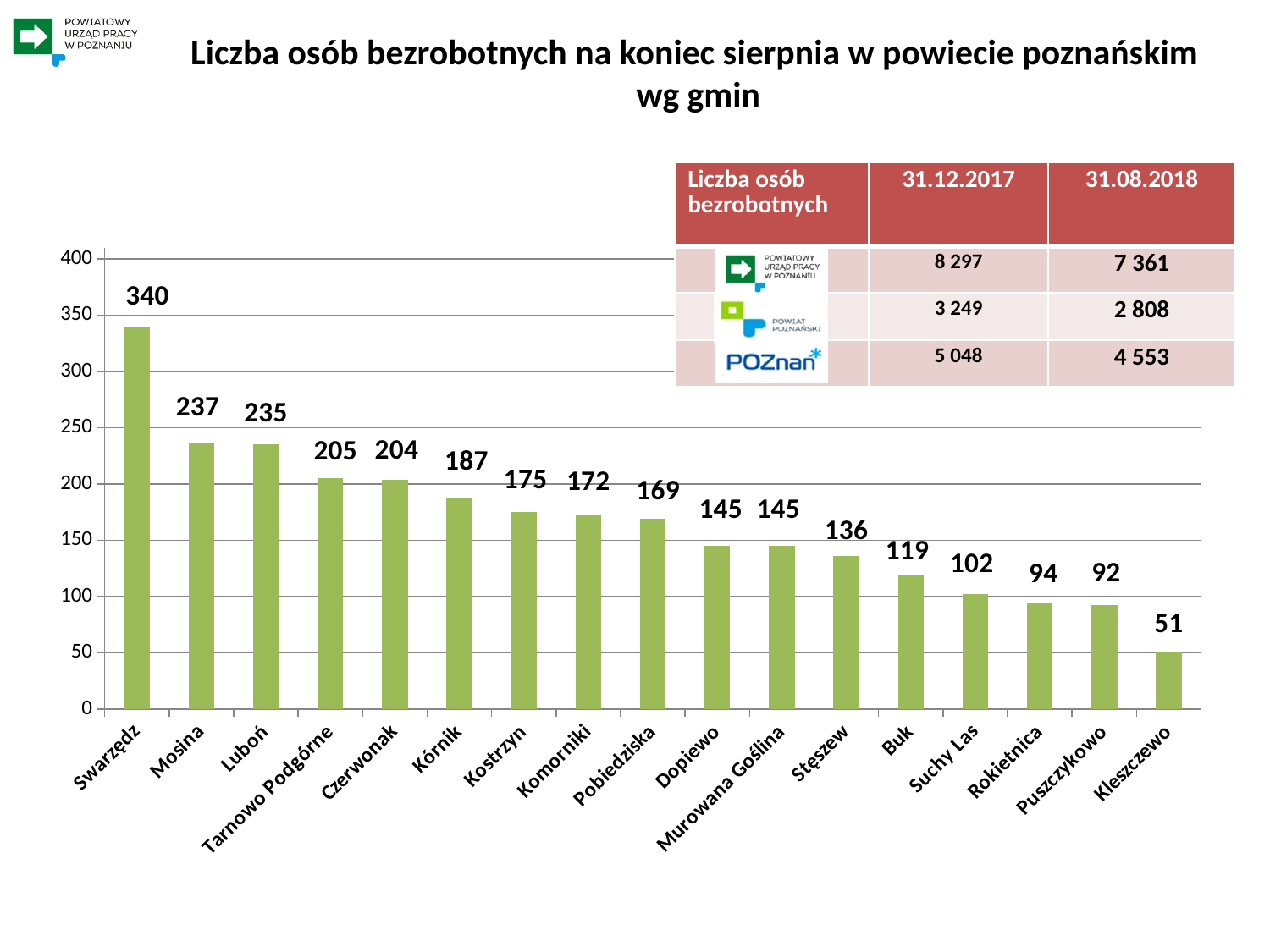
Which gmina has the lowest number of unemployed persons? Kleszczewo What is the value shown for Kórnik? 187 What is the value shown for Suchy Las? 102 Do the values rise or fall from left to right along the x axis? fall How many gminas are shown on the x axis of the chart? 17 Which gmina has the highest number of unemployed persons? Swarzędz Which has a larger value, Stęszew or Buk? Stęszew What is the difference between the values for Tarnowo Podgórne and Kleszczewo? 154 What is the difference between the values for Swarzędz and Mosina? 103 What type of chart is shown on the slide? bar chart What is the number of unemployed persons for Swarzędz? 340 Is the value for Pobiedziska greater or less than 150? greater